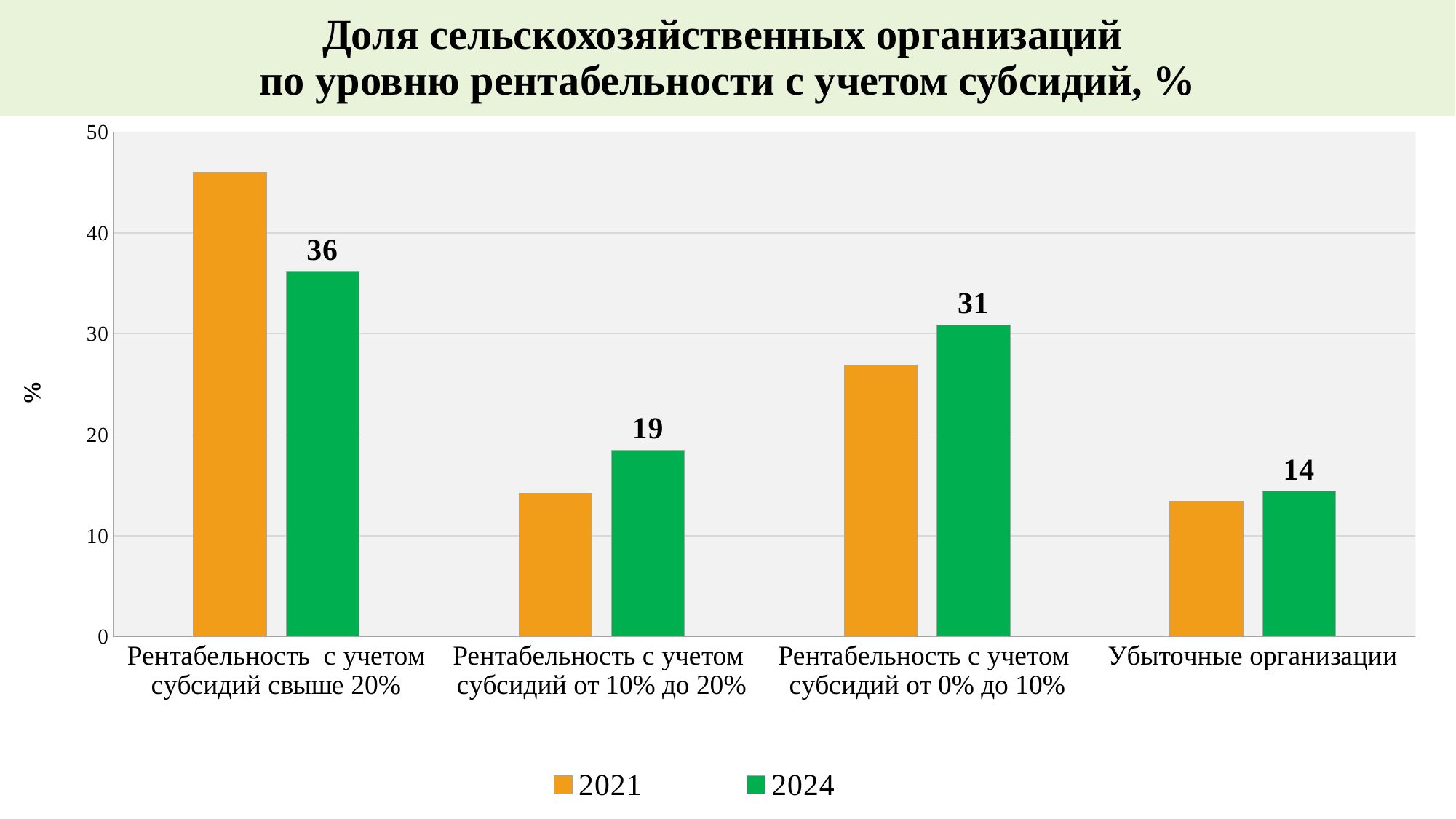
Is the 2021 value for "Рентабельность с учетом субсидий свыше 20%" greater or less than 40? greater What is the 2024 value for "Убыточные организации"? 14 What is the 2024 value for "Рентабельность с учетом субсидий свыше 20%"? 36 How many series does the legend list? 2 What is the difference between the 2024 values for "Рентабельность с учетом субсидий свыше 20%" and "Рентабельность с учетом субсидий от 10% до 20%"? 17 How many categories are shown on the x axis? 4 Is the 2021 value for "Рентабельность с учетом субсидий от 0% до 10%" greater or less than 30? less Which category has the highest 2024 value? Рентабельность с учетом субсидий свыше 20% Which category has the lowest 2024 value? Убыточные организации For "Рентабельность с учетом субсидий свыше 20%", which year has the larger value, 2021 or 2024? 2021 What is the 2024 value for "Рентабельность с учетом субсидий от 10% до 20%"? 19 What is the 2024 value for "Рентабельность с учетом субсидий от 0% до 10%"? 31